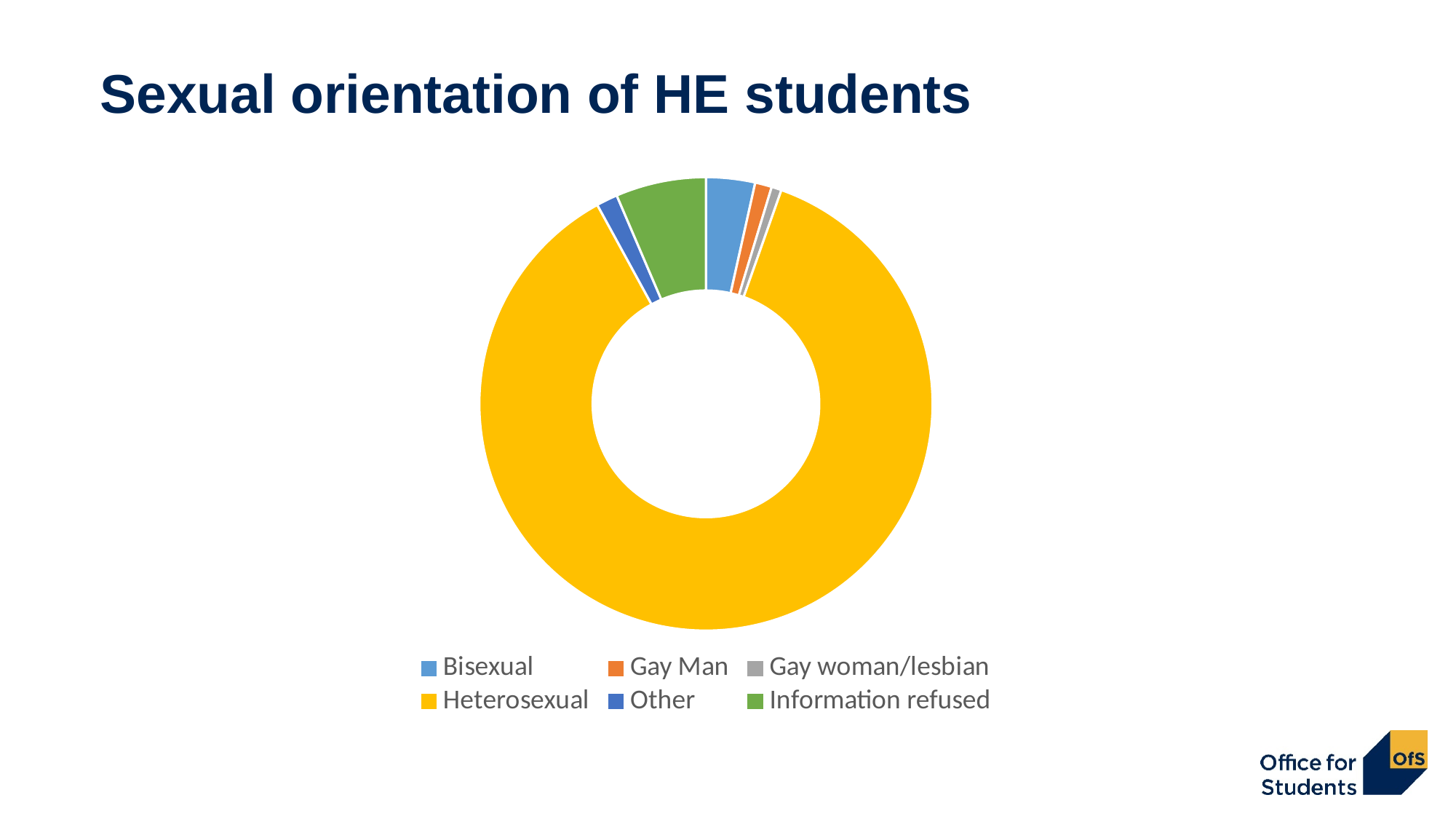
How many categories does the legend list? 6 Which is larger, the share for Bisexual or the share for Gay woman/lesbian? Bisexual What kind of chart is shown on the slide? doughnut chart Which colour represents Heterosexual in the chart? yellow Which is larger, the share for Information refused or the share for Other? Information refused What is the title of the chart on the slide? Sexual orientation of HE students Which is larger, the share for Heterosexual or the share for Information refused? Heterosexual Which category has the largest share of the chart? Heterosexual